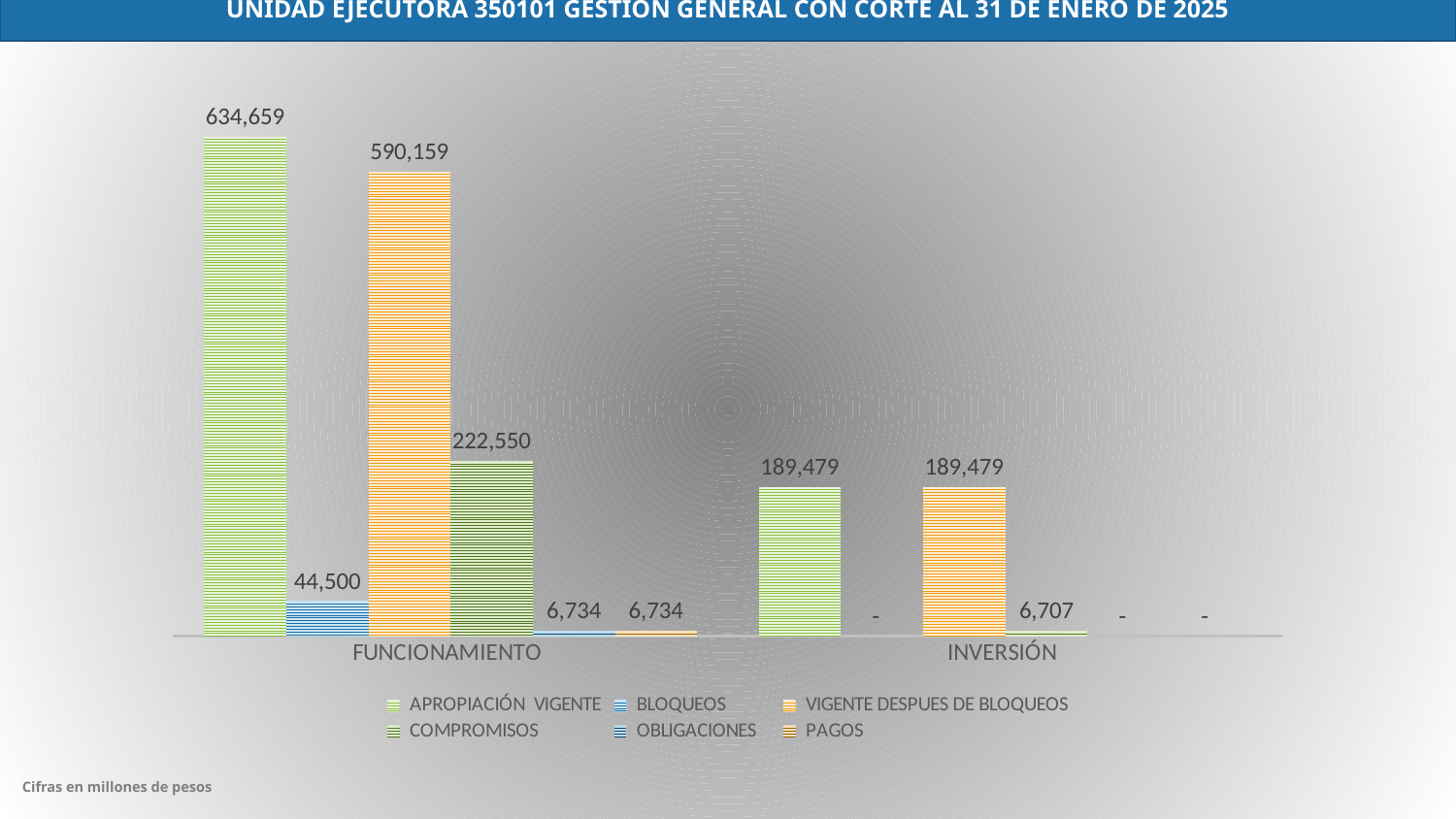
What is the COMPROMISOS value for INVERSIÓN? 6,707 How many series does the legend list? 6 What kind of chart is shown on the slide? Bar chart How many categories are shown on the x axis? 2 What is the VIGENTE DESPUES DE BLOQUEOS value for INVERSIÓN? 189,479 What is the difference between COMPROMISOS for FUNCIONAMIENTO and COMPROMISOS for INVERSIÓN? 215,843 Which category has the higher APROPIACIÓN VIGENTE value, FUNCIONAMIENTO or INVERSIÓN? FUNCIONAMIENTO What unit are the figures in, according to the note at the bottom of the slide? Millones de pesos Which series has the highest value for FUNCIONAMIENTO? APROPIACIÓN VIGENTE What is the BLOQUEOS value for FUNCIONAMIENTO? 44,500 What is the APROPIACIÓN VIGENTE value for FUNCIONAMIENTO? 634,659 What is the difference between APROPIACIÓN VIGENTE and VIGENTE DESPUES DE BLOQUEOS for FUNCIONAMIENTO? 44,500